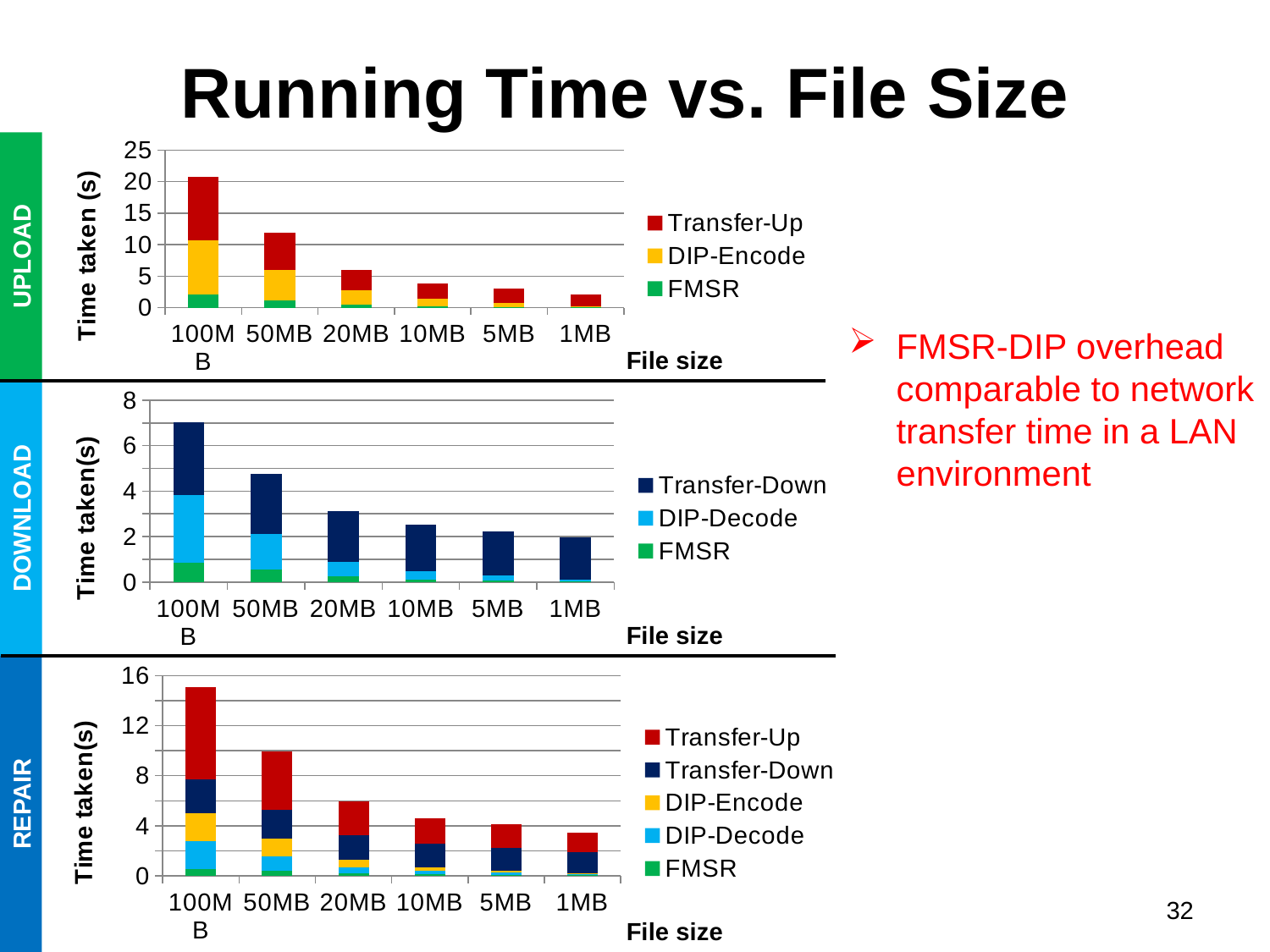
In the DOWNLOAD chart, is the total time for 100MB greater or less than 6? greater What kind of chart is the UPLOAD chart? stacked bar chart How many file-size categories are shown on the x axis of the UPLOAD chart? 6 In the REPAIR chart, is the total time for 100MB greater or less than 12? greater In the UPLOAD chart, is the total time for 100MB greater or less than 15? greater What is the x-axis label of the REPAIR chart? File size In the DOWNLOAD chart, do the total bar heights rise or fall from 100MB to 1MB along the x axis? fall How many series does the legend of the UPLOAD chart list? 3 In the DOWNLOAD chart, which file size has the shortest total bar? 1MB How many series does the legend of the REPAIR chart list? 5 In the UPLOAD chart, which file size has the tallest total bar? 100MB